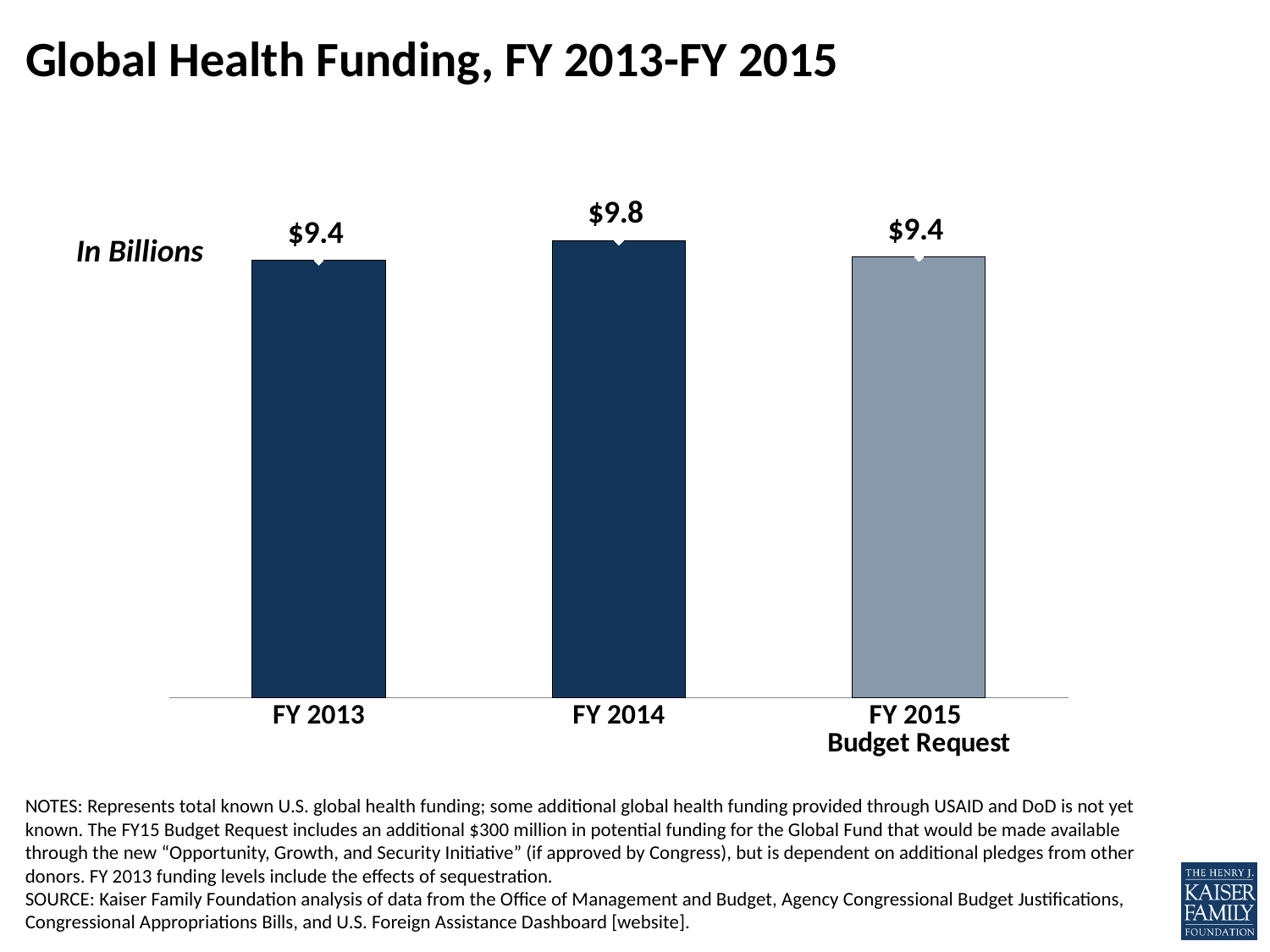
What is the difference between the FY 2014 value and the FY 2013 value? $0.4 Which is larger, the value for FY 2014 or the value for the FY 2015 Budget Request? FY 2014 Does the funding value rise or fall from FY 2014 to the FY 2015 Budget Request? Fall In what units are the values on the chart expressed? In Billions What is the value shown for the FY 2015 Budget Request? $9.4 How many bars are shown in the chart? 3 What kind of chart is shown on the slide? Bar chart What is the global health funding value for FY 2014? $9.8 What is the global health funding value for FY 2013? $9.4 What is the title of the chart? Global Health Funding, FY 2013-FY 2015 Which fiscal year has the highest global health funding value? FY 2014